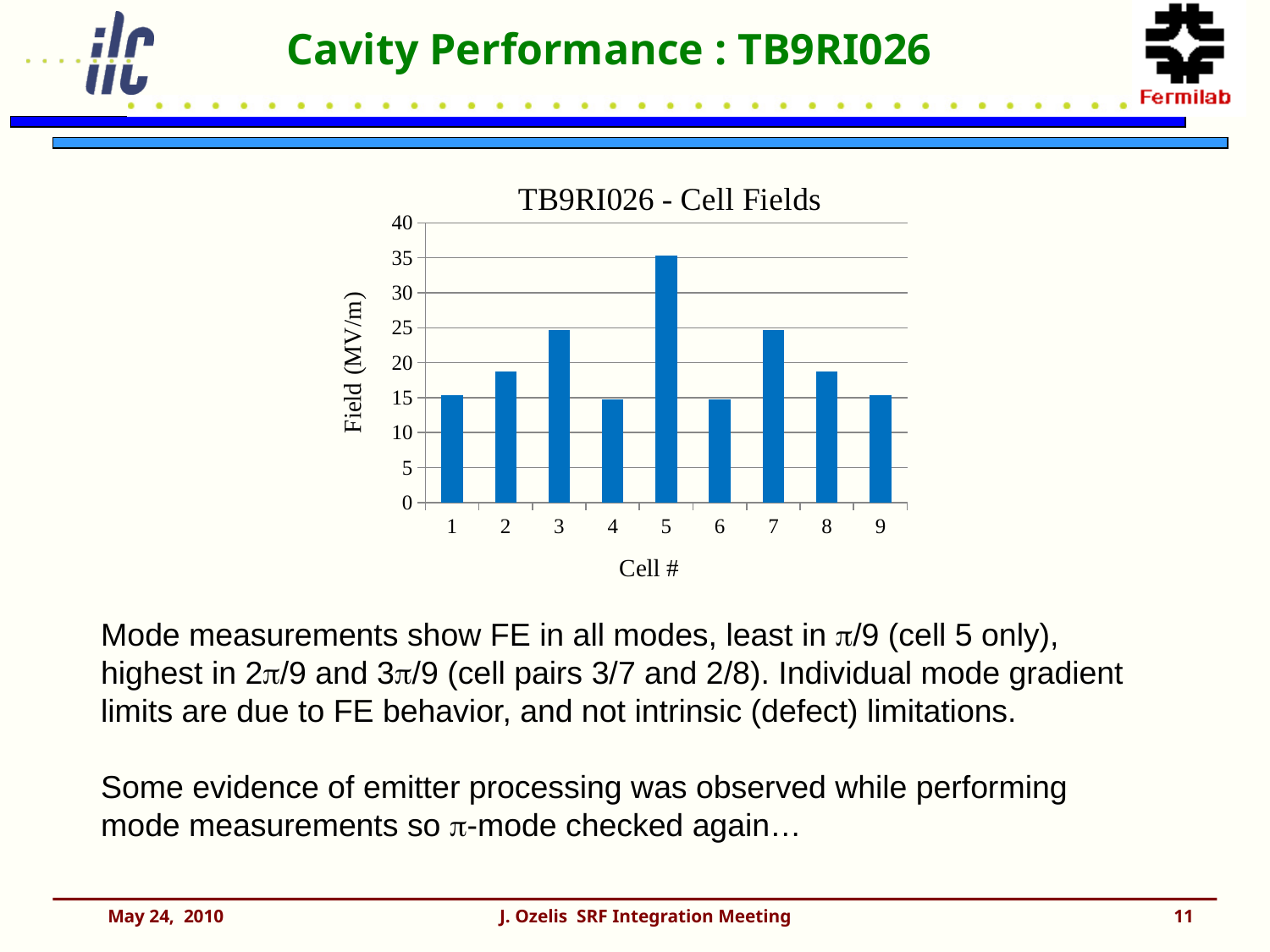
What kind of chart is shown on the slide? bar chart What is the label of the vertical axis of the chart? Field (MV/m) Which has a higher field, cell 5 or cell 7? cell 5 Which has a higher field, cell 8 or cell 9? cell 8 Which cell has the highest field in the chart? 5 Which has a higher field, cell 3 or cell 2? cell 3 Is the field for cell 3 greater or less than 20 MV/m? greater Is the field for cell 5 greater or less than 30 MV/m? greater How many cells (bars) are plotted in the chart? 9 What is the title of the chart? TB9RI026 - Cell Fields Is the field for cell 1 greater or less than 20 MV/m? less